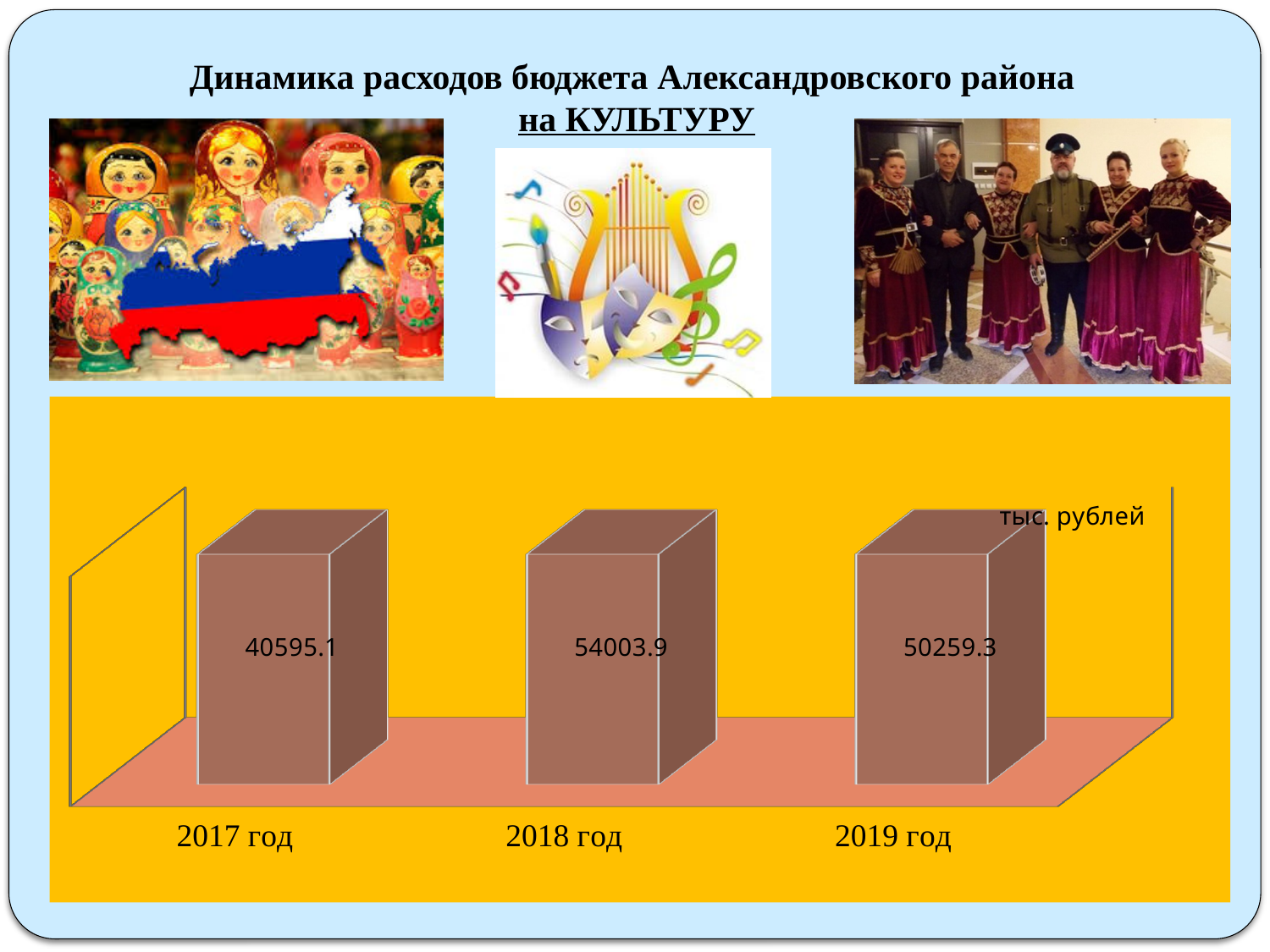
Which is larger, the value for 2019 год or the value for 2017 год? 2019 год What unit is indicated on the chart? тыс. рублей How many years are shown in the chart? 3 What is the value for 2018 год? 54003.9 What is the value for 2019 год? 50259.3 Which year has the highest value? 2018 год Do the values rise or fall from 2018 год to 2019 год? Fall What is the difference between the values for 2018 год and 2017 год? 13408.8 Which year has the lowest value? 2017 год What kind of chart is shown on the slide? Bar chart What is the value for 2017 год? 40595.1 What is the difference between the values for 2018 год and 2019 год? 3744.6